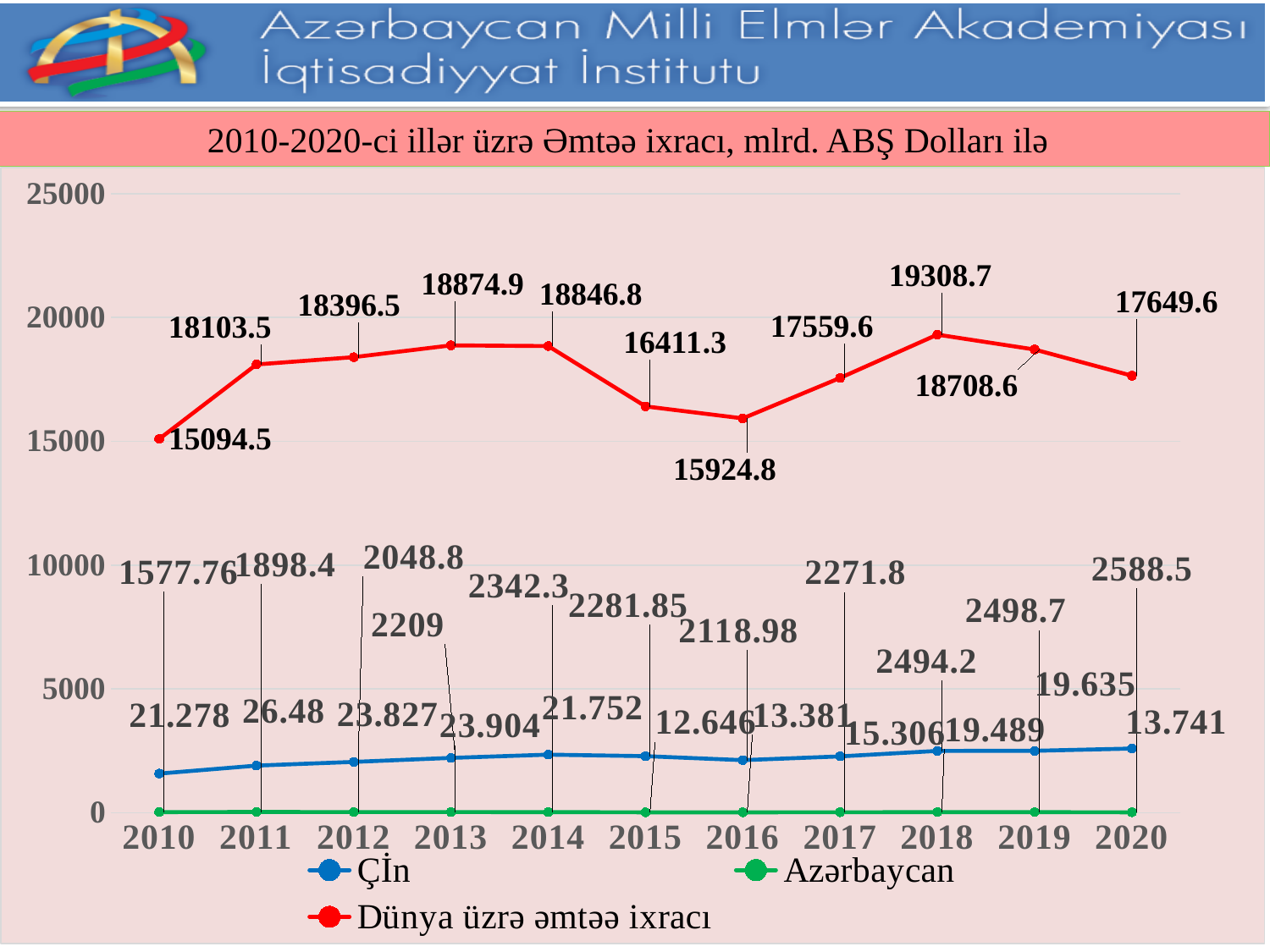
In which year is Dünya üzrə əmtəə ixracı at its lowest? 2010 What is the title of the chart? 2010-2020-ci illər üzrə Əmtəə ixracı, mlrd. ABŞ Dolları ilə How many series does the legend list? 3 How many years are plotted along the x axis? 11 Is the value of Dünya üzrə əmtəə ixracı in 2013 greater or less than 20000? less What is the value of Dünya üzrə əmtəə ixracı in 2018? 19308.7 What is the value for Azərbaycan in 2011? 26.48 What is the difference between the Dünya üzrə əmtəə ixracı values in 2011 and 2010? 3009 What type of chart is shown on the slide? line chart In which year is the value for Çİn highest? 2020 Which is larger: the value for Çİn in 2014 or in 2015? 2014 What is the value for Çİn in 2020? 2588.5